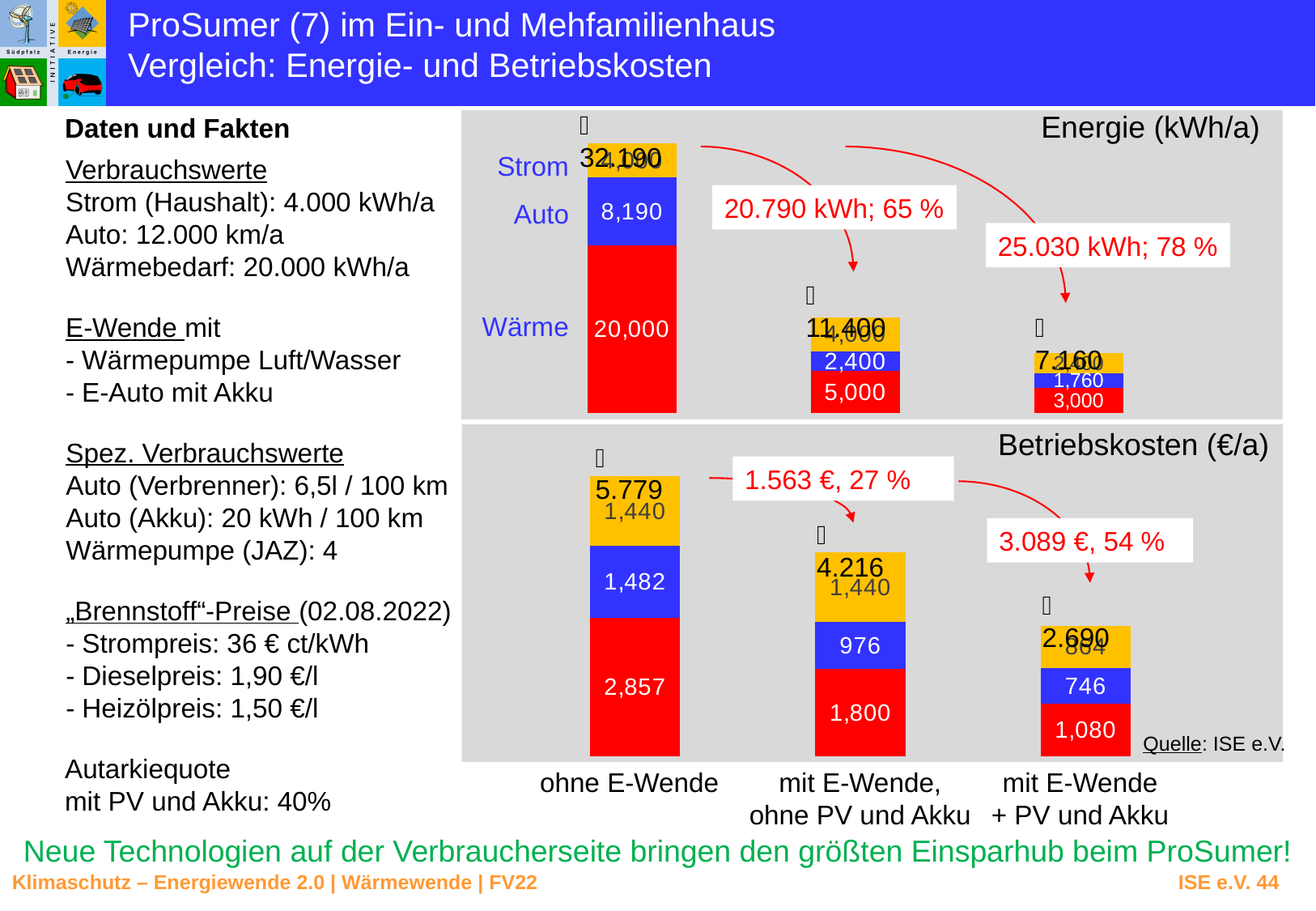
In the Energie (kWh/a) chart, what is the Auto value for 'mit E-Wende + PV und Akku'? 1,760 In the Betriebskosten (€/a) chart, which category has the highest total? ohne E-Wende How many categories are shown along the x axis of the Energie (kWh/a) chart? 3 What kind of chart is the Betriebskosten (€/a) chart? stacked bar chart In the Betriebskosten (€/a) chart, what is the Auto value for 'mit E-Wende, ohne PV und Akku'? 976 In the Betriebskosten (€/a) chart, what is the total of the stacked bar for 'mit E-Wende + PV und Akku'? 2.690 In the Energie (kWh/a) chart, what is the total of the stacked bar for 'mit E-Wende, ohne PV und Akku'? 11,400 In the Energie (kWh/a) chart, what is the difference between the Wärme values for 'ohne E-Wende' and 'mit E-Wende, ohne PV und Akku'? 15,000 In the Energie (kWh/a) chart, what is the Wärme value for 'ohne E-Wende'? 20,000 In the Betriebskosten (€/a) chart, is the Wärme value for 'ohne E-Wende' or for 'mit E-Wende + PV und Akku' larger? ohne E-Wende In the Betriebskosten (€/a) chart, what is the Wärme value for 'ohne E-Wende'? 2,857 In the Energie (kWh/a) chart, what is the Auto value for 'ohne E-Wende'? 8,190